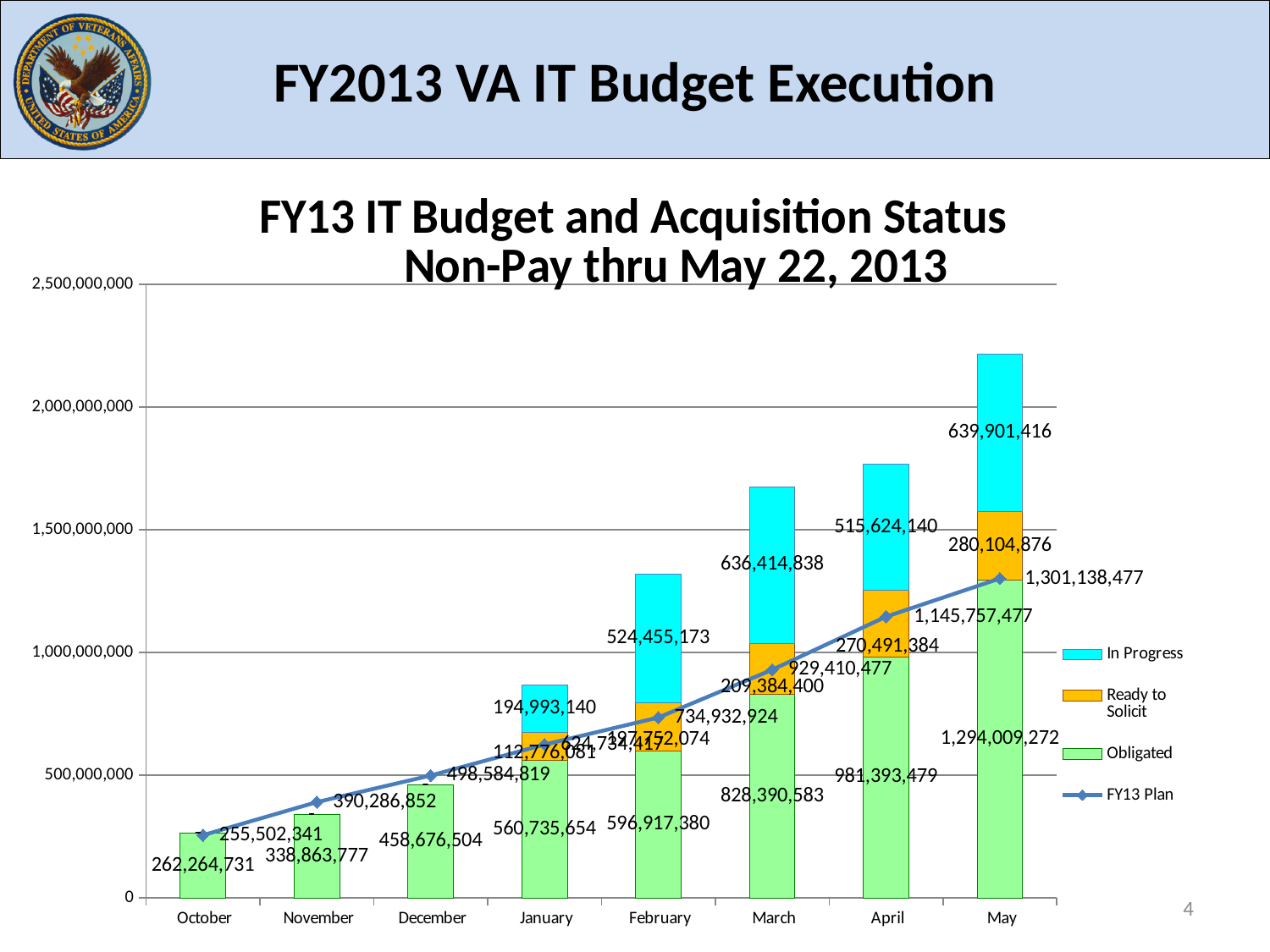
Which month has the lowest Obligated value? October What is the Ready to Solicit value for May? 280,104,876 What is the FY13 Plan value for April? 1,145,757,477 Which is larger, the FY13 Plan value for October or the Obligated value for October? Obligated (262,264,731) Which month has the highest Obligated value? May Do the Obligated values rise or fall from October to May? rise What is the Obligated value for May? 1,294,009,272 What is the difference between the Obligated values for May and April? 312,615,793 How many months are shown on the x axis? 8 What is the In Progress value for March? 636,414,838 Is the total height of the May stacked bar greater or less than 2,000,000,000? greater How many series does the legend list? 4